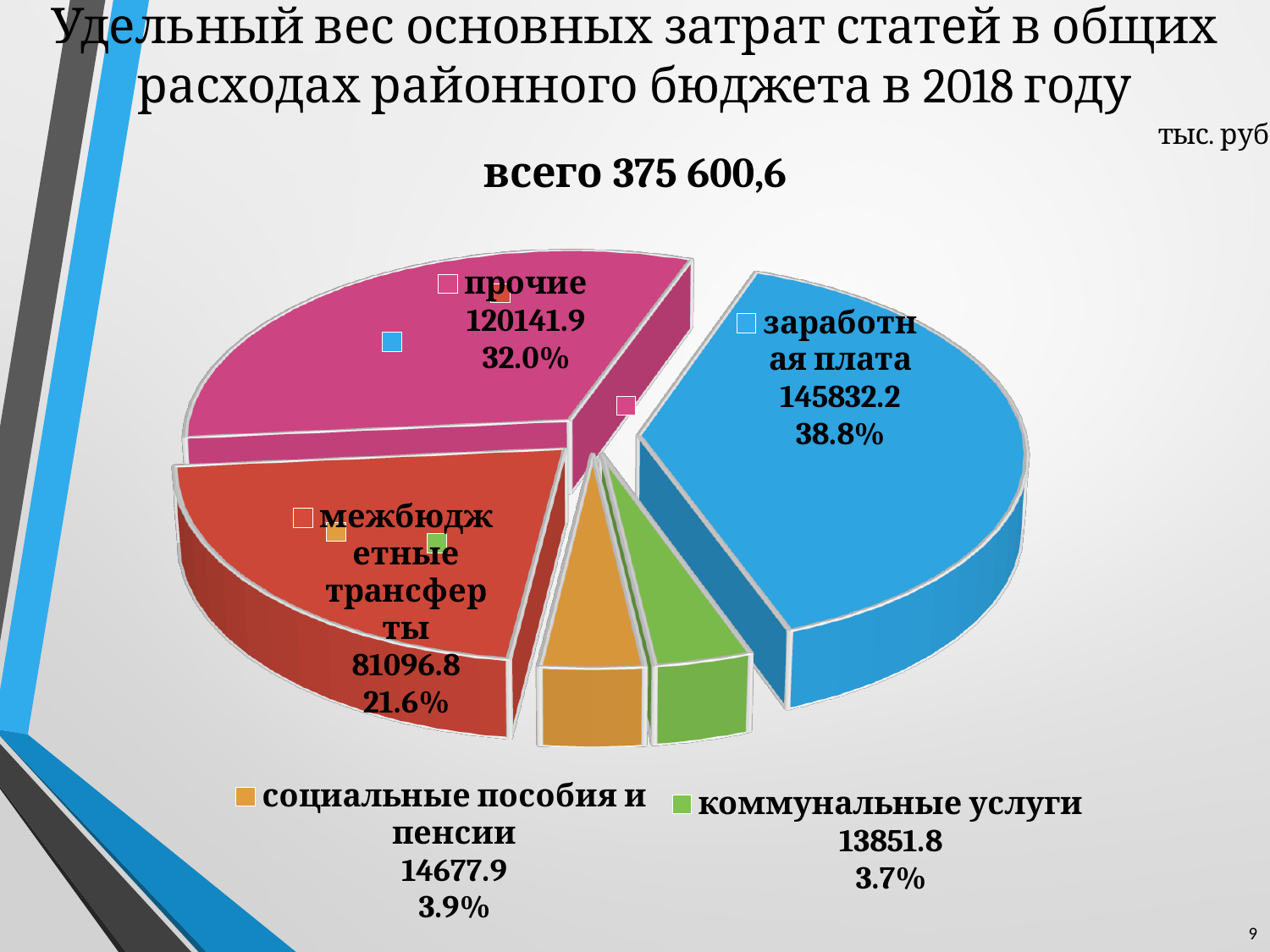
What total is stated above the chart? всего 375 600,6 Which category has the largest share of the pie? заработная плата What kind of chart is shown on the slide? pie chart What share of the pie does коммунальные услуги represent? 3.7% Which is larger, the value for социальные пособия и пенсии or the value for коммунальные услуги? социальные пособия и пенсии What is the difference between the values for заработная плата and прочие? 25690.3 Which category has the smallest share of the pie? коммунальные услуги What is the value for межбюджетные трансферты? 81096.8 What share of the pie does прочие represent? 32.0% What is the value for социальные пособия и пенсии? 14677.9 What is the value for заработная плата? 145832.2 How many slices does the pie chart have? 5